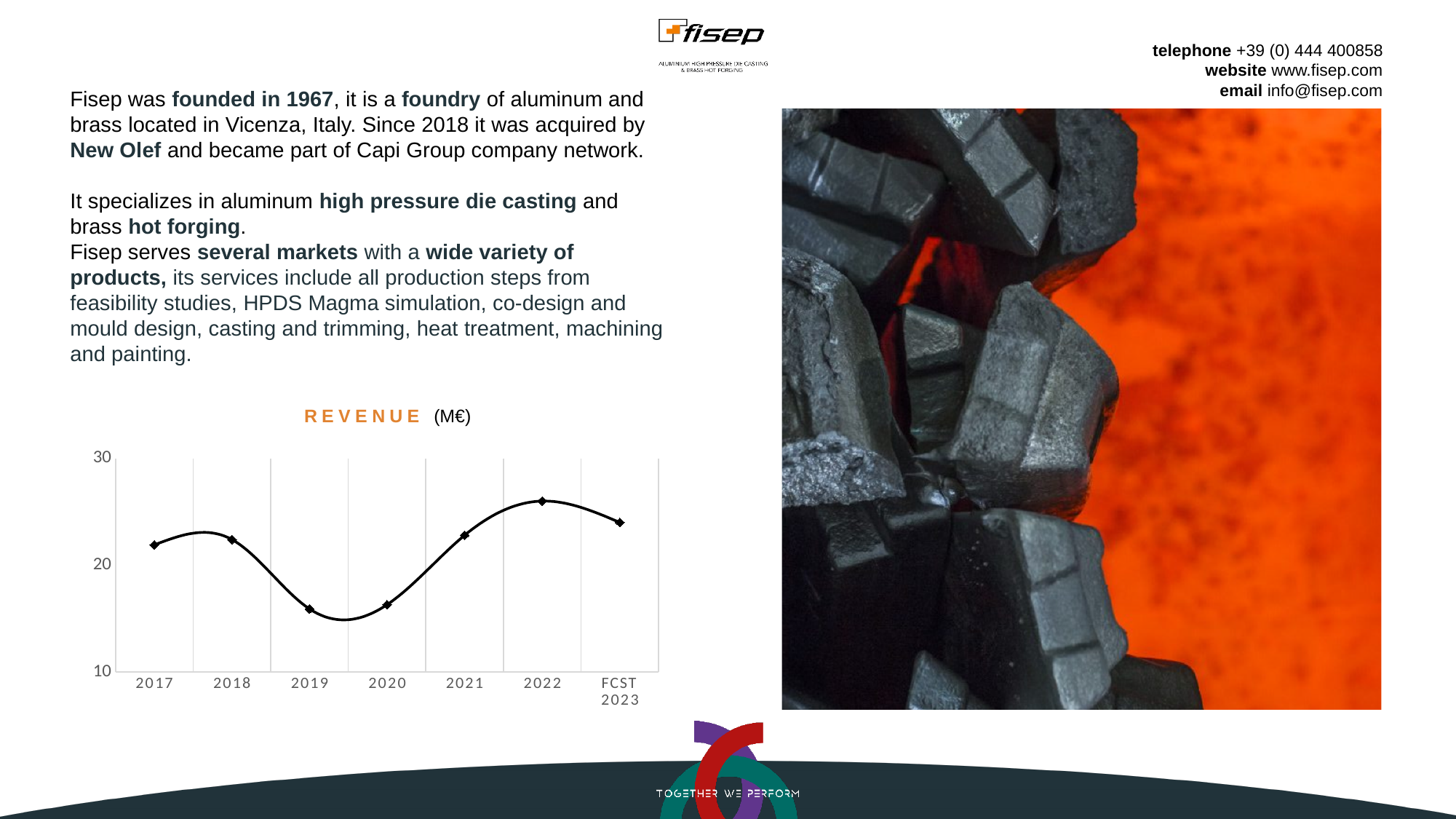
What kind of chart is shown on the slide? line chart Is the revenue for 2022 greater or less than 20? greater Is the revenue for 2019 greater or less than 20? less Does revenue rise or fall from 2020 to 2022? rise Which year has the highest revenue on the chart? 2022 Does revenue rise or fall from 2022 to FCST 2023? fall What unit is given in the chart title for revenue? M€ Is the revenue for 2020 greater or less than 20? less How many points are plotted on the revenue chart? 7 Which is larger, the revenue for 2018 or for 2019? 2018 Which is larger, the revenue for 2021 or for 2020? 2021